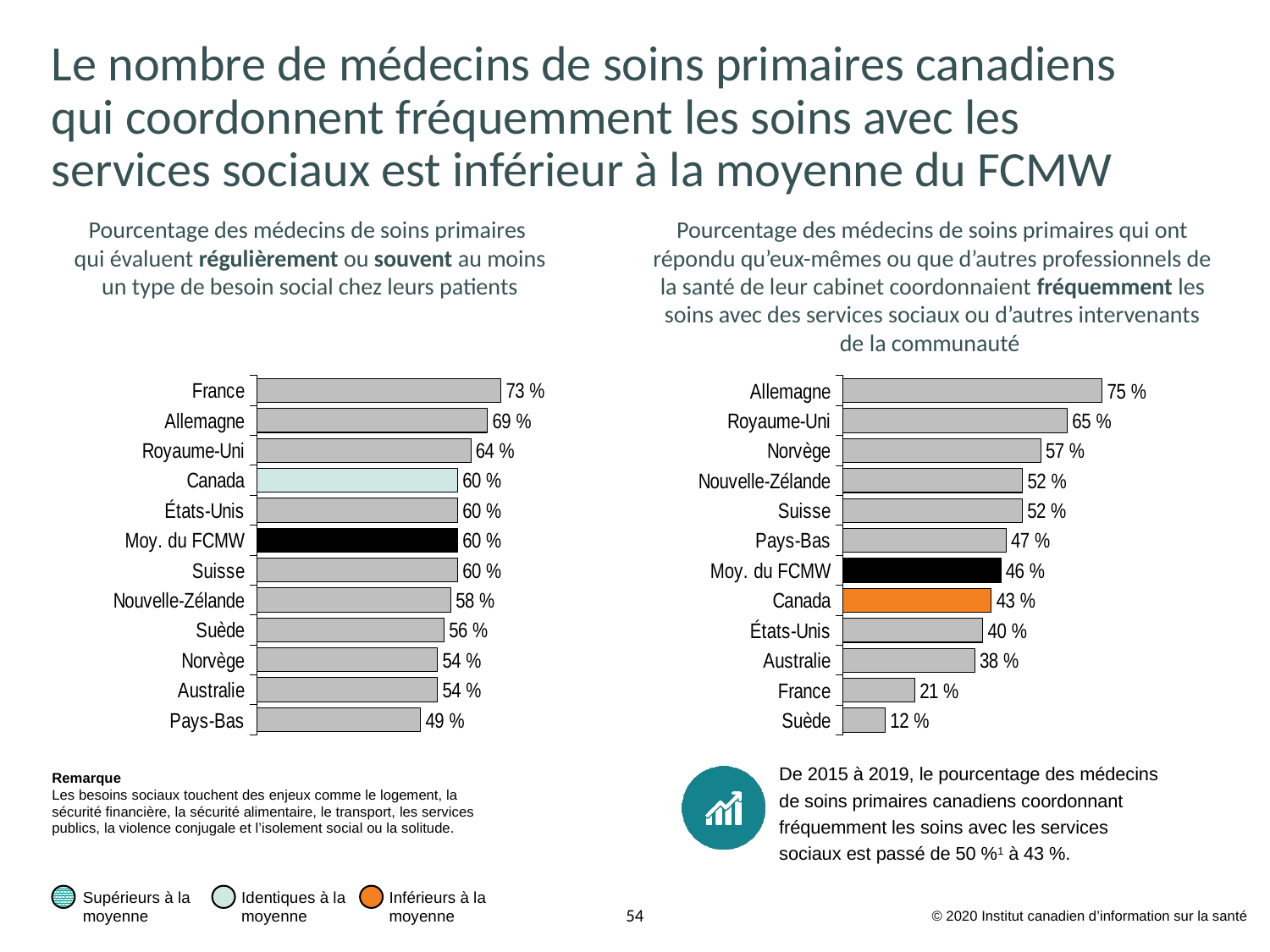
In the right chart, which country has the highest value? Allemagne In the left chart, which country has the highest value? France In the right chart, which country has the lowest value? Suède In the right chart, what is the value for Moy. du FCMW? 46 % What type of chart is the right chart? Bar chart In the left chart, how many bars are plotted? 12 In the right chart, what is the difference between Allemagne and Suède? 63 % In the left chart, what is the value for Canada? 60 % In the right chart, what is the value for Canada? 43 % In the left chart, which country has the lowest value? Pays-Bas In the right chart, which is larger, the value for Canada or the value for Moy. du FCMW? Moy. du FCMW In the left chart, what is the difference between France and Pays-Bas? 24 %